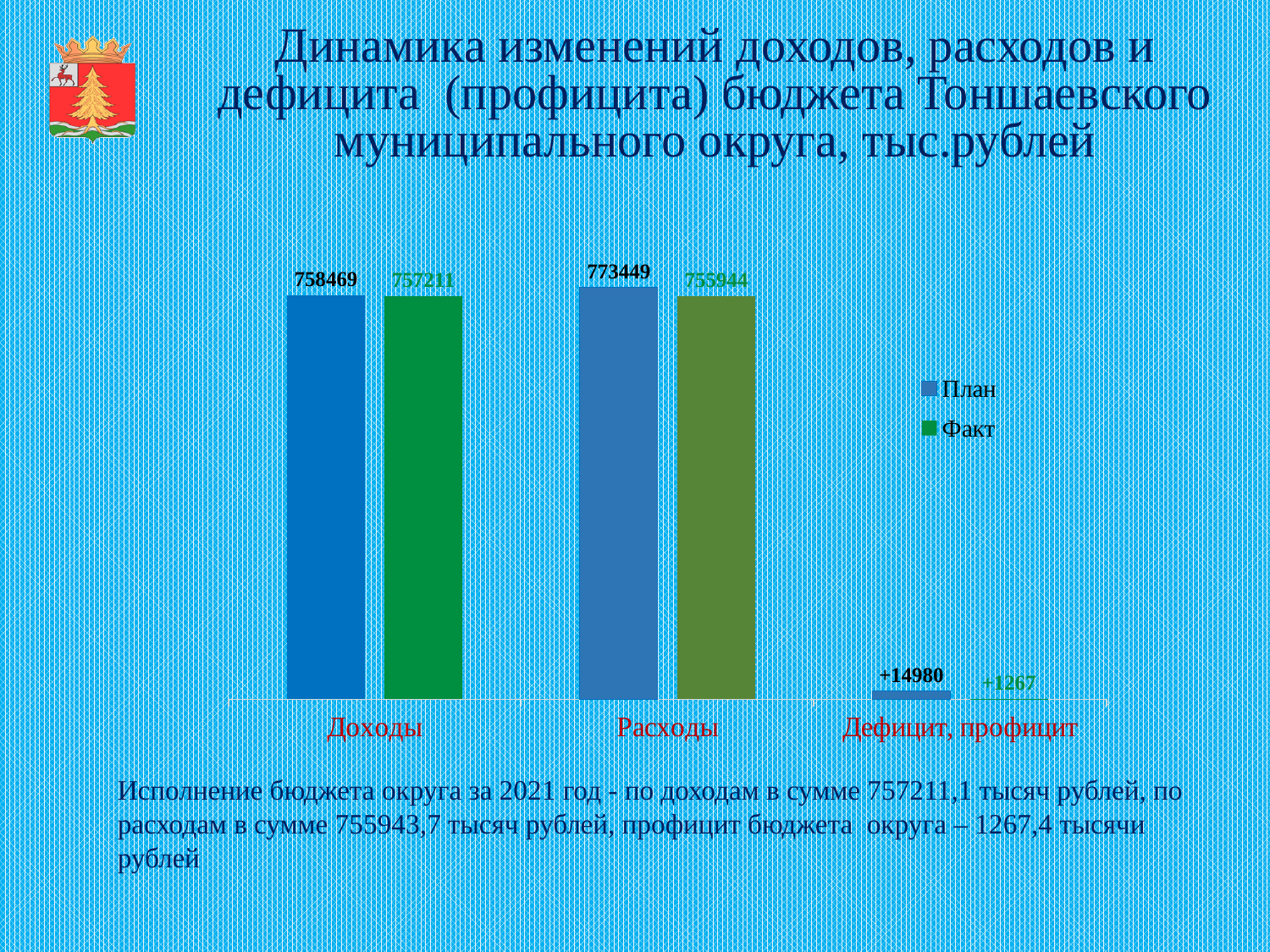
What is the Факт value for Доходы? 757211 What is the Факт value for Дефицит, профицит? +1267 How many categories are shown on the x axis? 3 What is the План value for Доходы? 758469 What is the Факт value for Расходы? 755944 What kind of chart is shown on the slide? Bar chart What is the План value for Расходы? 773449 What is the План value for Дефицит, профицит? +14980 Which category has the highest План value? Расходы What is the difference between the План and Факт values for Расходы? 17505 How many series does the legend list? 2 Which category has the lowest Факт value? Дефицит, профицит